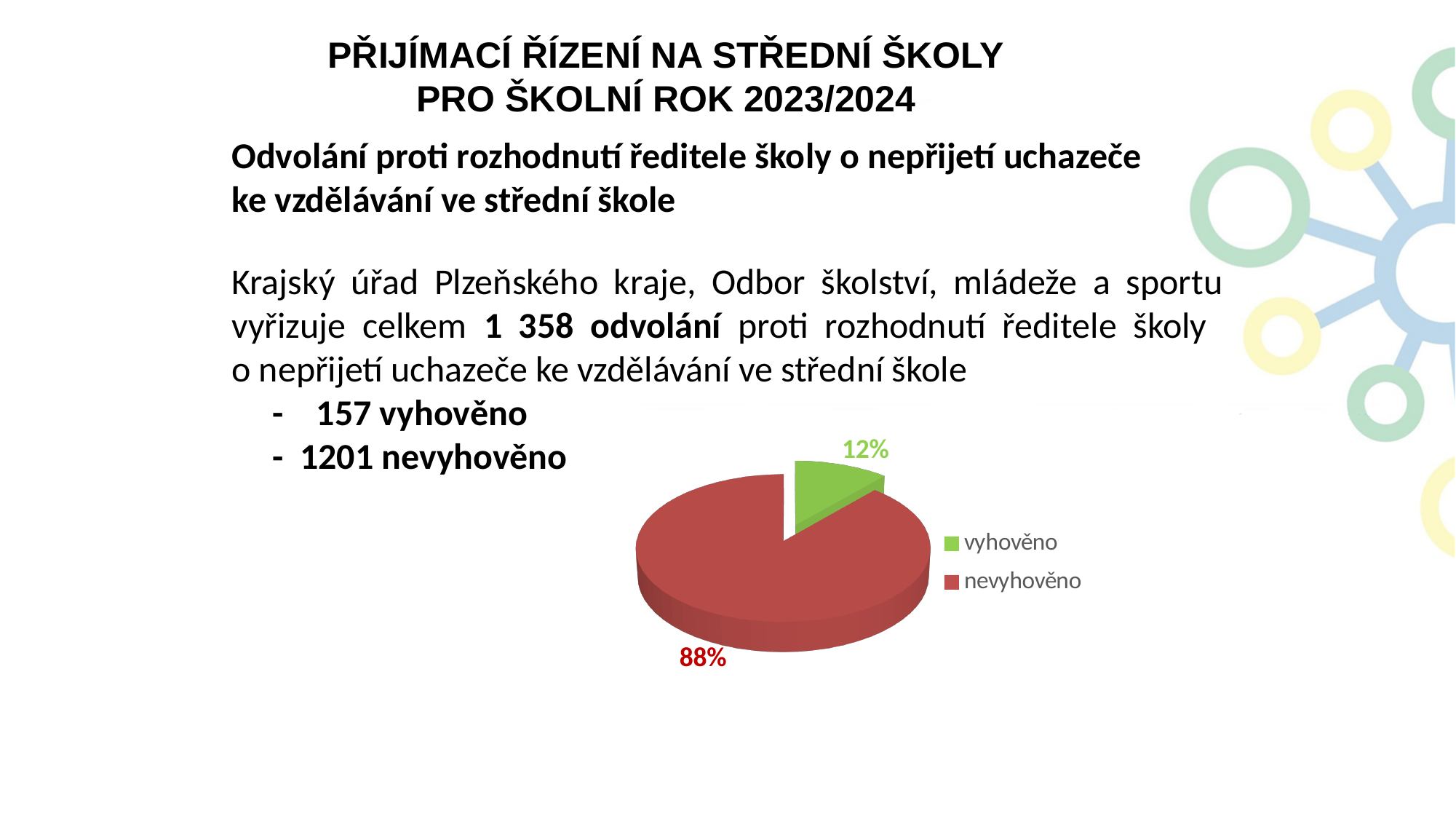
Which slice of the pie is the largest? nevyhověno What share of the pie does "vyhověno" represent? 12% How many entries does the legend list? 2 What share of the pie does "nevyhověno" represent? 88% Which is larger, the share for "vyhověno" or for "nevyhověno"? nevyhověno What colour is the "vyhověno" slice? green Which slice of the pie is the smallest? vyhověno How many slices does the pie chart have? 2 What is the difference in percentage points between the "nevyhověno" and "vyhověno" shares? 76 What colour is the "nevyhověno" slice? red What kind of chart is shown on the slide? pie chart